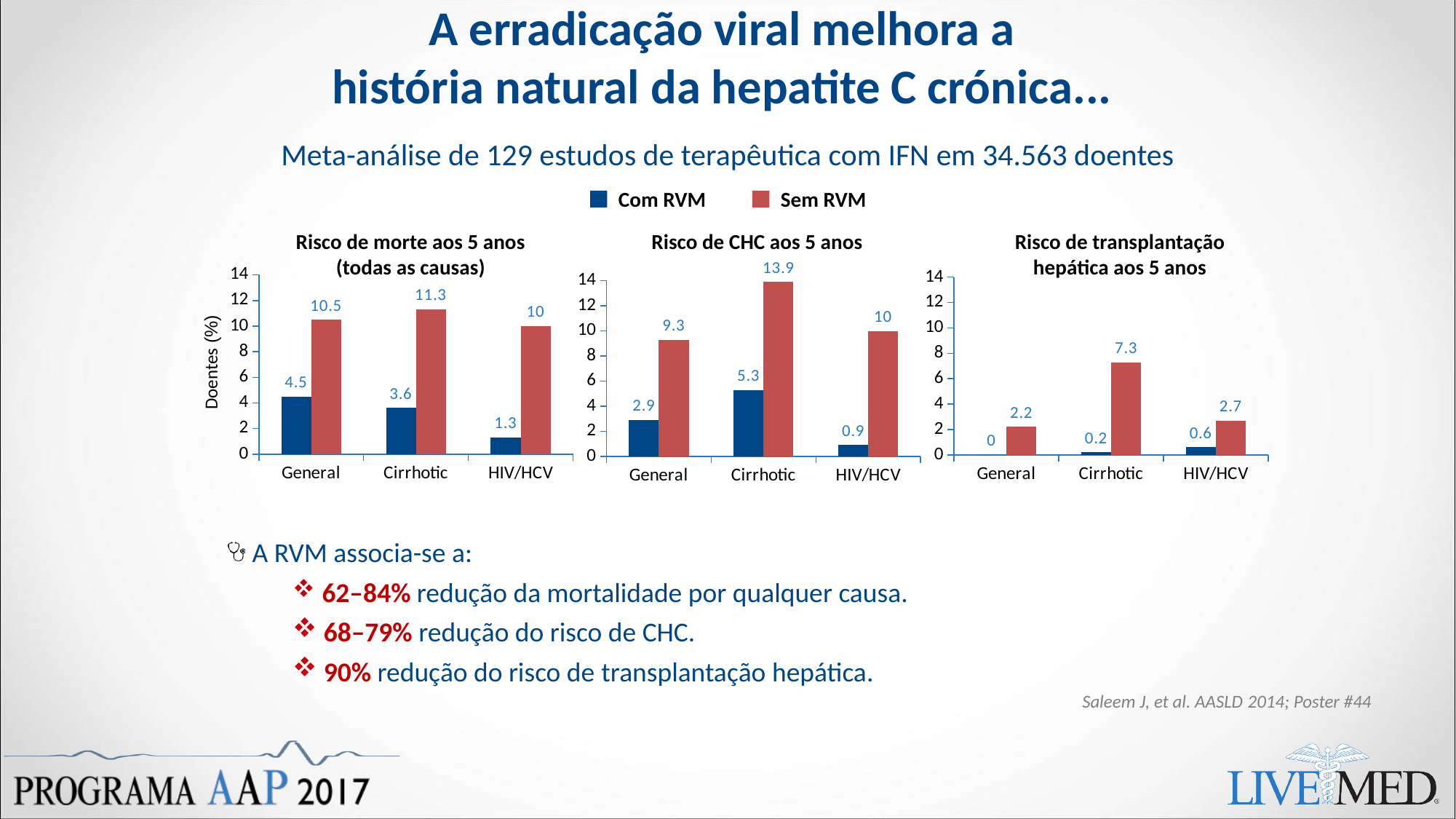
In the 'Risco de morte aos 5 anos (todas as causas)' chart, which category has the lowest Com RVM value? HIV/HCV How many series does the shared legend list for the charts? 2 In the 'Risco de CHC aos 5 anos' chart, what is the difference between the Sem RVM and Com RVM values for General? 6.4 How many categories are shown on the x axis of the 'Risco de transplantação hepática aos 5 anos' chart? 3 In the 'Risco de morte aos 5 anos (todas as causas)' chart, what is the value for Cirrhotic in the Sem RVM series? 11.3 What kind of chart is the 'Risco de CHC aos 5 anos' chart? Bar chart In the 'Risco de CHC aos 5 anos' chart, is the Sem RVM value for Cirrhotic greater or less than 12? greater In the 'Risco de CHC aos 5 anos' chart, what is the value for HIV/HCV in the Com RVM series? 0.9 In the 'Risco de morte aos 5 anos (todas as causas)' chart, which is larger: the Sem RVM value for General or the Sem RVM value for HIV/HCV? General In the 'Risco de transplantação hepática aos 5 anos' chart, what is the value for General in the Com RVM series? 0 In the 'Risco de transplantação hepática aos 5 anos' chart, what is the difference between the Sem RVM and Com RVM values for Cirrhotic? 7.1 In the 'Risco de CHC aos 5 anos' chart, which category has the highest Sem RVM value? Cirrhotic